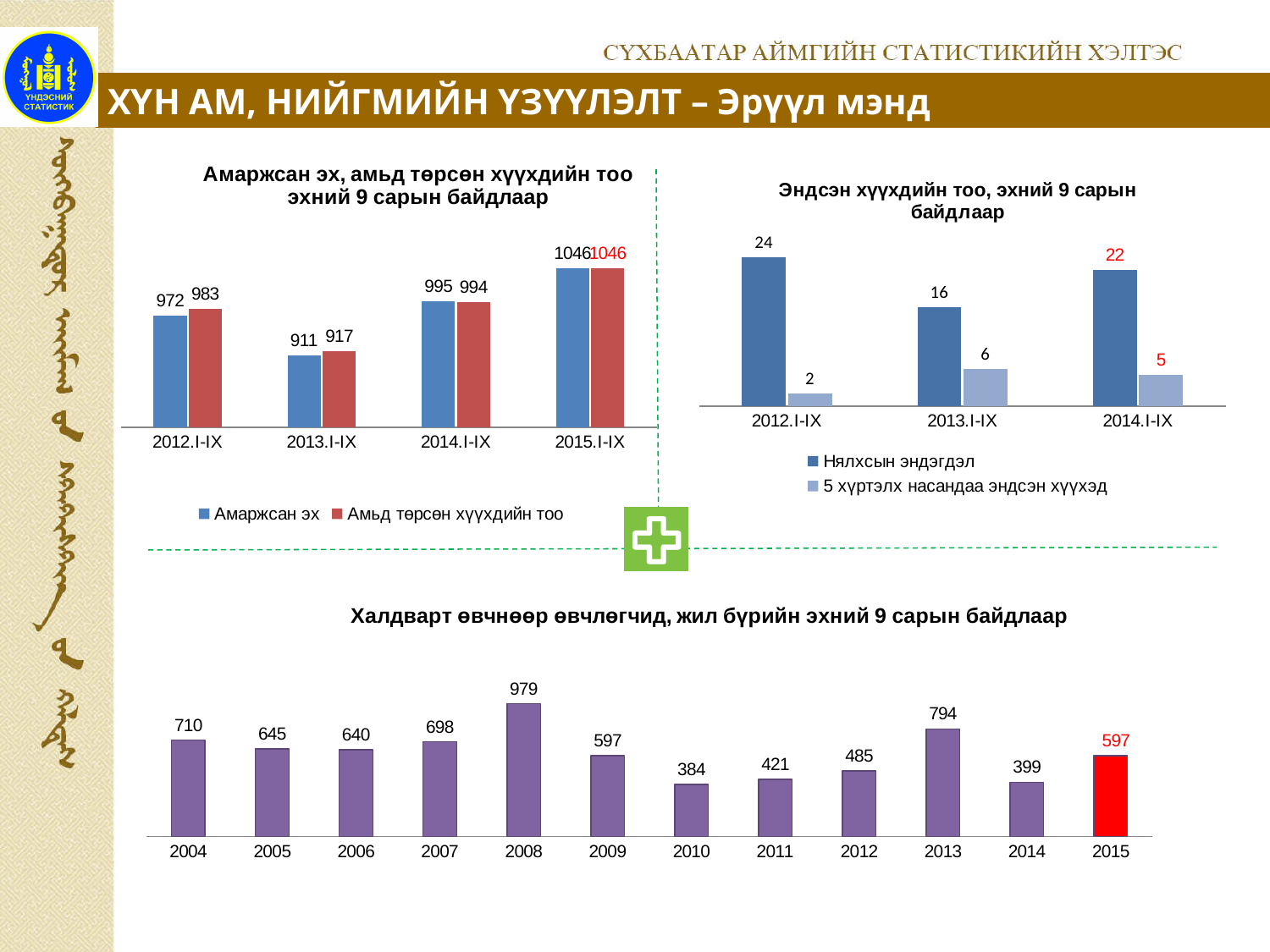
In the top-right chart (Эндсэн хүүхдийн тоо), which period has the lowest value for 5 хүртэлх насандаа эндсэн хүүхэд? 2012.I-IX In the top-left chart (Амаржсан эх, амьд төрсөн хүүхдийн тоо), what is the value for Амаржсан эх in 2013.I-IX? 911 In the bottom chart (Халдварт өвчнөөр өвчлөгчид), which is larger, the value for 2013 or the value for 2015? 2013 In the top-left chart (Амаржсан эх, амьд төрсөн хүүхдийн тоо), what is the value for Амьд төрсөн хүүхдийн тоо in 2012.I-IX? 983 In the top-right chart (Эндсэн хүүхдийн тоо), what is the value for Нялхсын эндэгдэл in 2013.I-IX? 16 In the top-left chart (Амаржсан эх, амьд төрсөн хүүхдийн тоо), which period has the highest value for Амаржсан эх? 2015.I-IX In the bottom chart (Халдварт өвчнөөр өвчлөгчид), how many years are shown on the x axis? 12 In the top-right chart (Эндсэн хүүхдийн тоо), what is the difference between Нялхсын эндэгдэл and 5 хүртэлх насандаа эндсэн хүүхэд in 2014.I-IX? 17 In the top-left chart (Амаржсан эх, амьд төрсөн хүүхдийн тоо), how many series does the legend list? 2 In the top-left chart (Амаржсан эх, амьд төрсөн хүүхдийн тоо), what is the difference between Амьд төрсөн хүүхдийн тоо in 2015.I-IX and 2014.I-IX? 52 In the bottom chart (Халдварт өвчнөөр өвчлөгчид), what is the value for 2008? 979 In the bottom chart (Халдварт өвчнөөр өвчлөгчид), which year has the lowest value? 2010